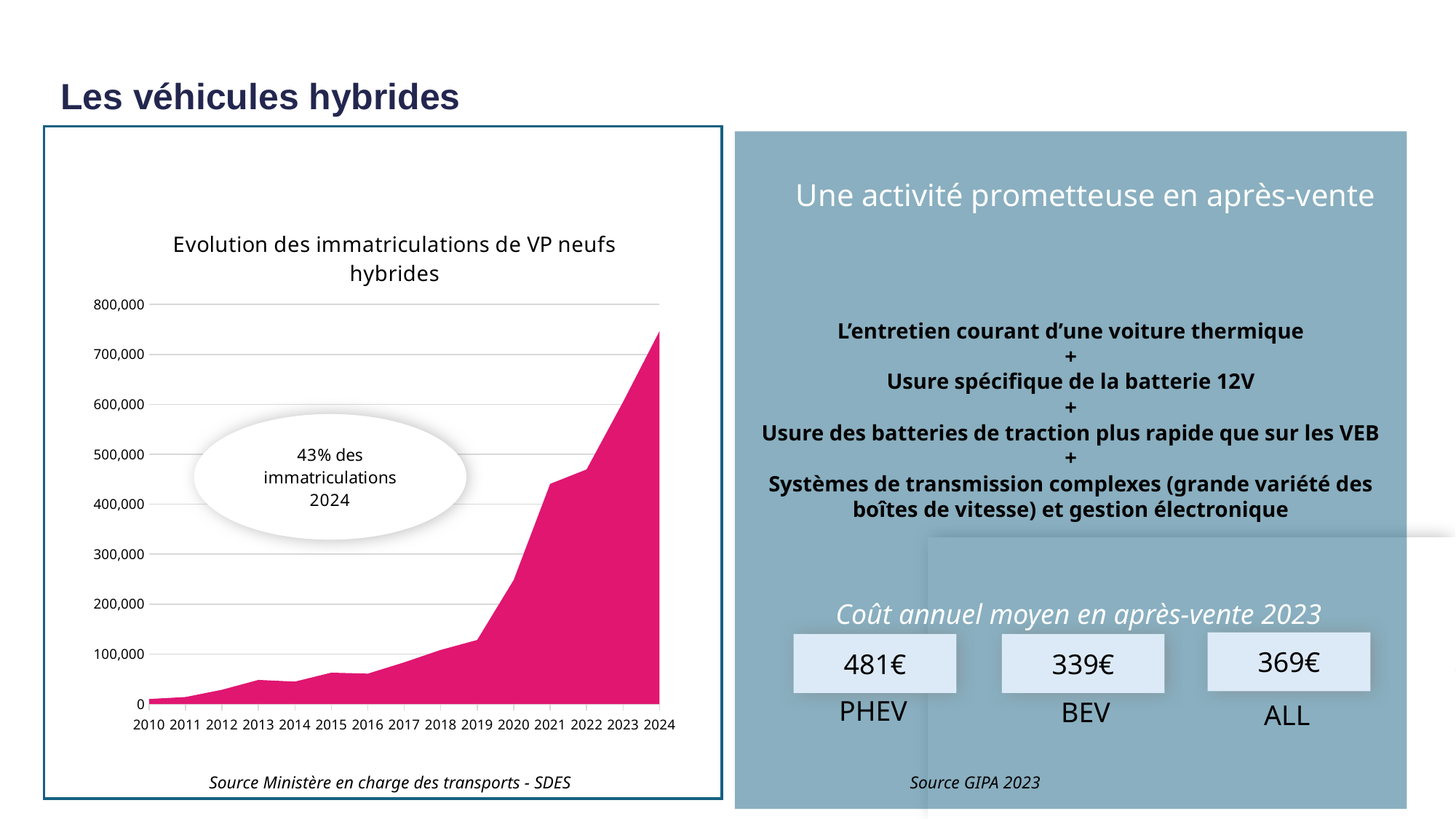
Which year has the highest number of registrations in the chart? 2024 What is the title of the chart? Evolution des immatriculations de VP neufs hybrides Is the value for 2021 greater or less than 400,000? greater What share of 2024 registrations does the callout on the chart attribute to hybrids? 43% Which year has the lowest number of registrations in the chart? 2010 Which year has the larger value, 2019 or 2021? 2021 What kind of chart is shown on the slide? Area chart Is the value for 2024 greater or less than 700,000? greater How many years are plotted along the x axis of the chart? 15 Is the value for 2023 greater or less than 500,000? greater Do the values in the chart generally rise or fall from 2010 to 2024? Rise